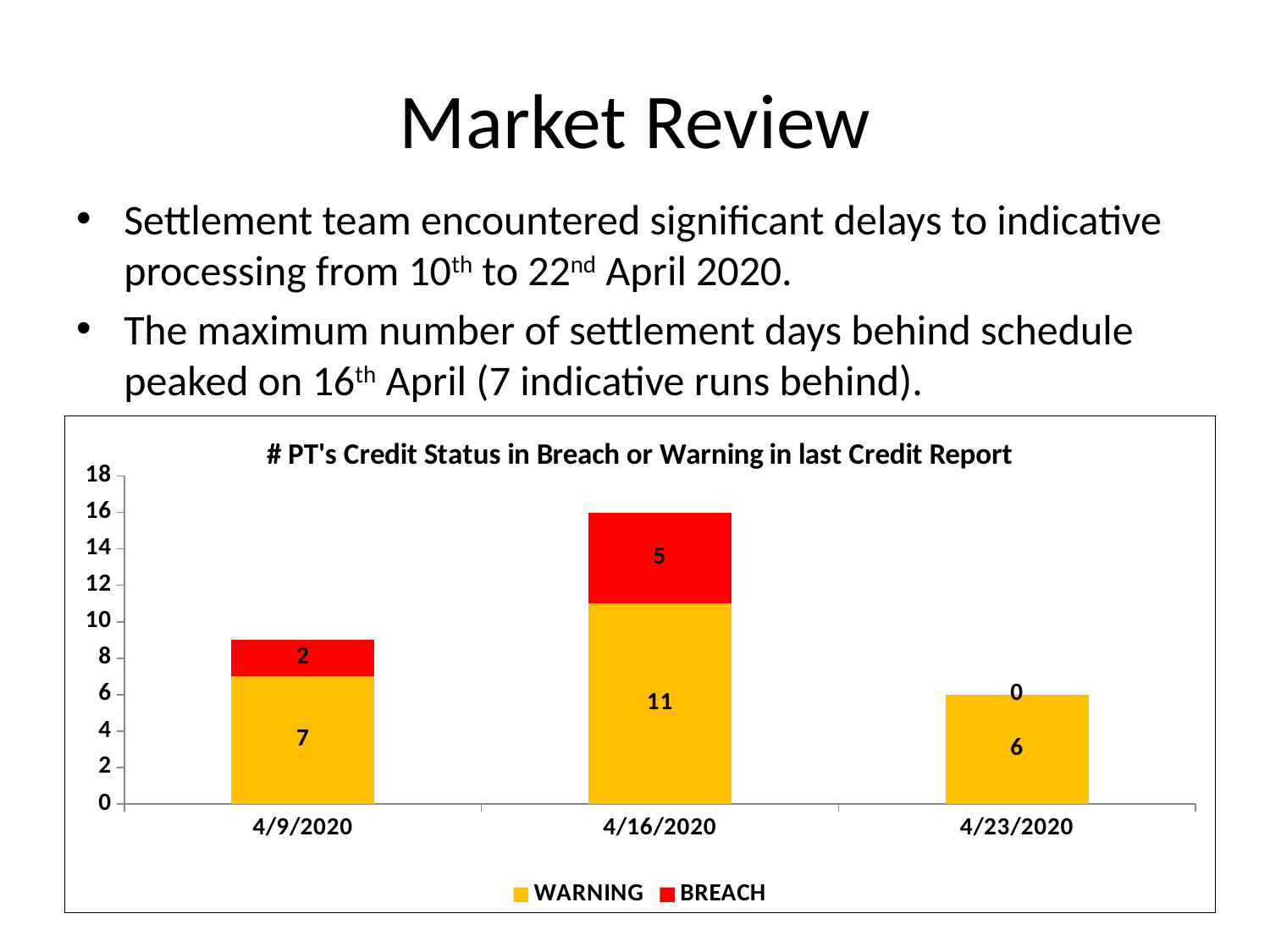
What is the difference between the WARNING values for 4/16/2020 and 4/9/2020? 4 What is the BREACH value for 4/23/2020? 0 What is the total of the stacked bar for 4/16/2020? 16 Which is larger, the BREACH value for 4/16/2020 or for 4/9/2020? 4/16/2020 What kind of chart is shown? Stacked bar chart How many dates are shown on the x axis? 3 How many series does the legend list? 2 Which date has the highest WARNING value? 4/16/2020 What is the total of the stacked bar for 4/9/2020? 9 Which date has the lowest BREACH value? 4/23/2020 What is the WARNING value for 4/16/2020? 11 What is the BREACH value for 4/9/2020? 2